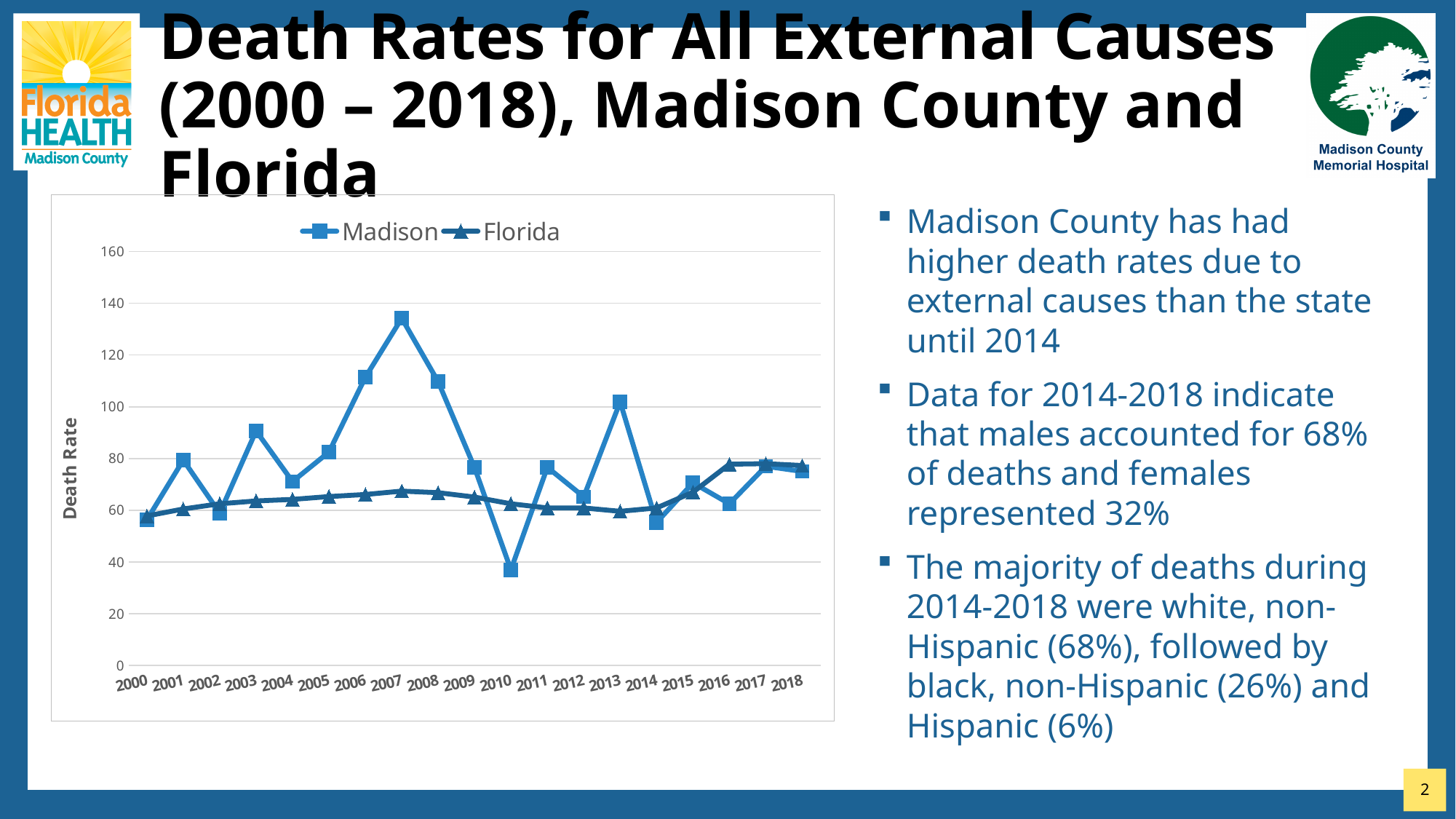
Is the Madison death rate in 2007 greater or less than 120? greater What is the label on the vertical axis of the chart? Death Rate How many series does the chart legend list? 2 Is the Madison death rate in 2006 greater or less than 100? greater Which series has the higher death rate in 2010, Madison or Florida? Florida Which series has the higher death rate in 2016, Madison or Florida? Florida In which year does the Madison series reach its lowest death rate? 2010 In which year does the Madison series reach its highest death rate? 2007 How many years are plotted along the x axis of the chart? 19 What type of chart is shown on the slide? Line chart Is the Madison death rate in 2010 greater or less than 40? less Does the Madison death rate rise or fall from 2007 to 2010? Fall